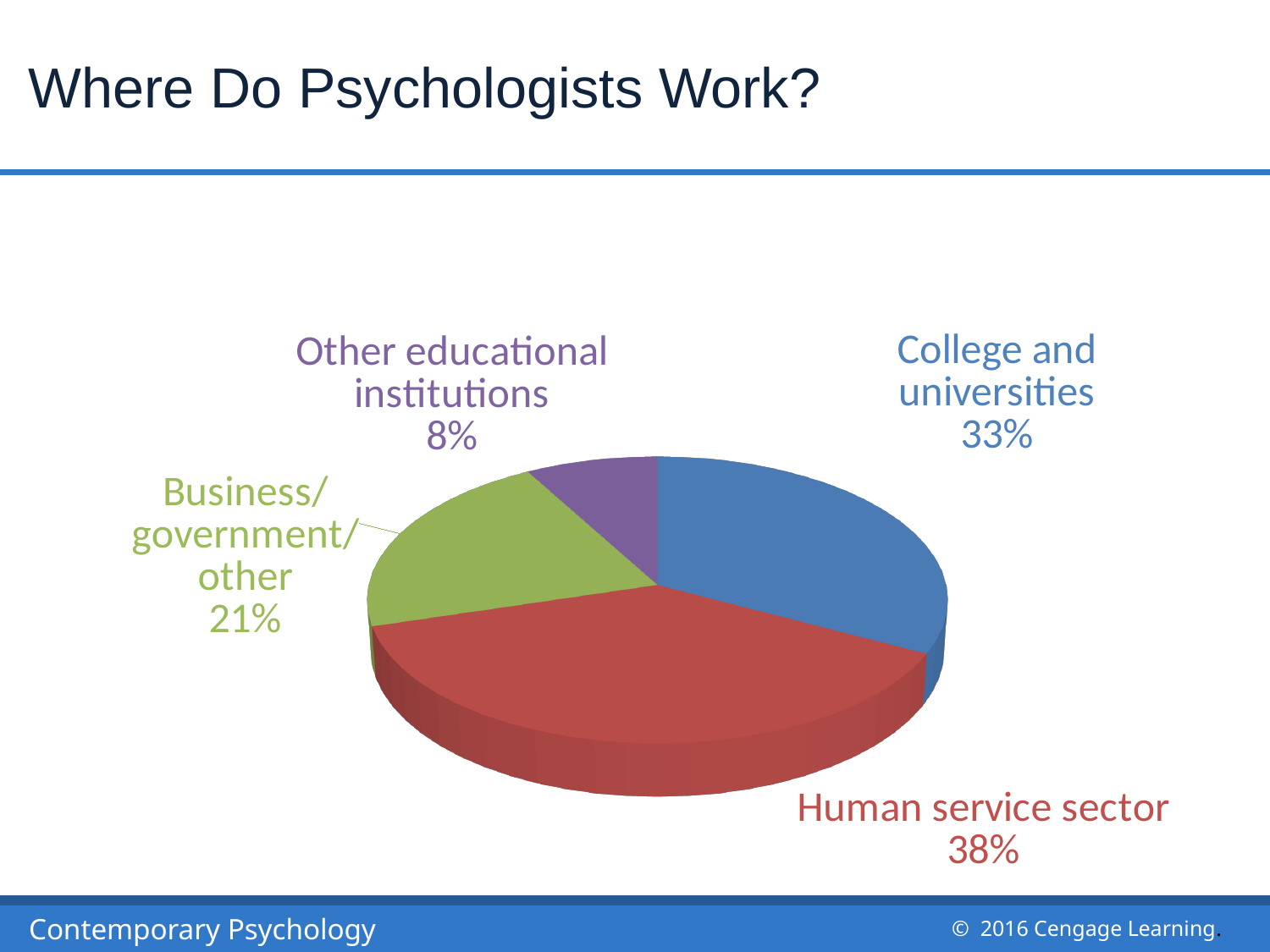
What percentage of psychologists work in the human service sector? 38% What colour is the slice for the human service sector? Red What percentage of psychologists work in colleges and universities? 33% What percentage of psychologists work in business/government/other? 21% What is the difference in percentage points between business/government/other and other educational institutions? 13 Which work setting has the largest share of psychologists? Human service sector How many percentage points larger is the human service sector share than the college and universities share? 5 How many work settings are shown in the pie chart? 4 Which is larger: the share for college and universities or the share for business/government/other? College and universities What percentage of psychologists work in other educational institutions? 8% Which work setting has the smallest share of psychologists? Other educational institutions What type of chart is shown on the slide? Pie chart